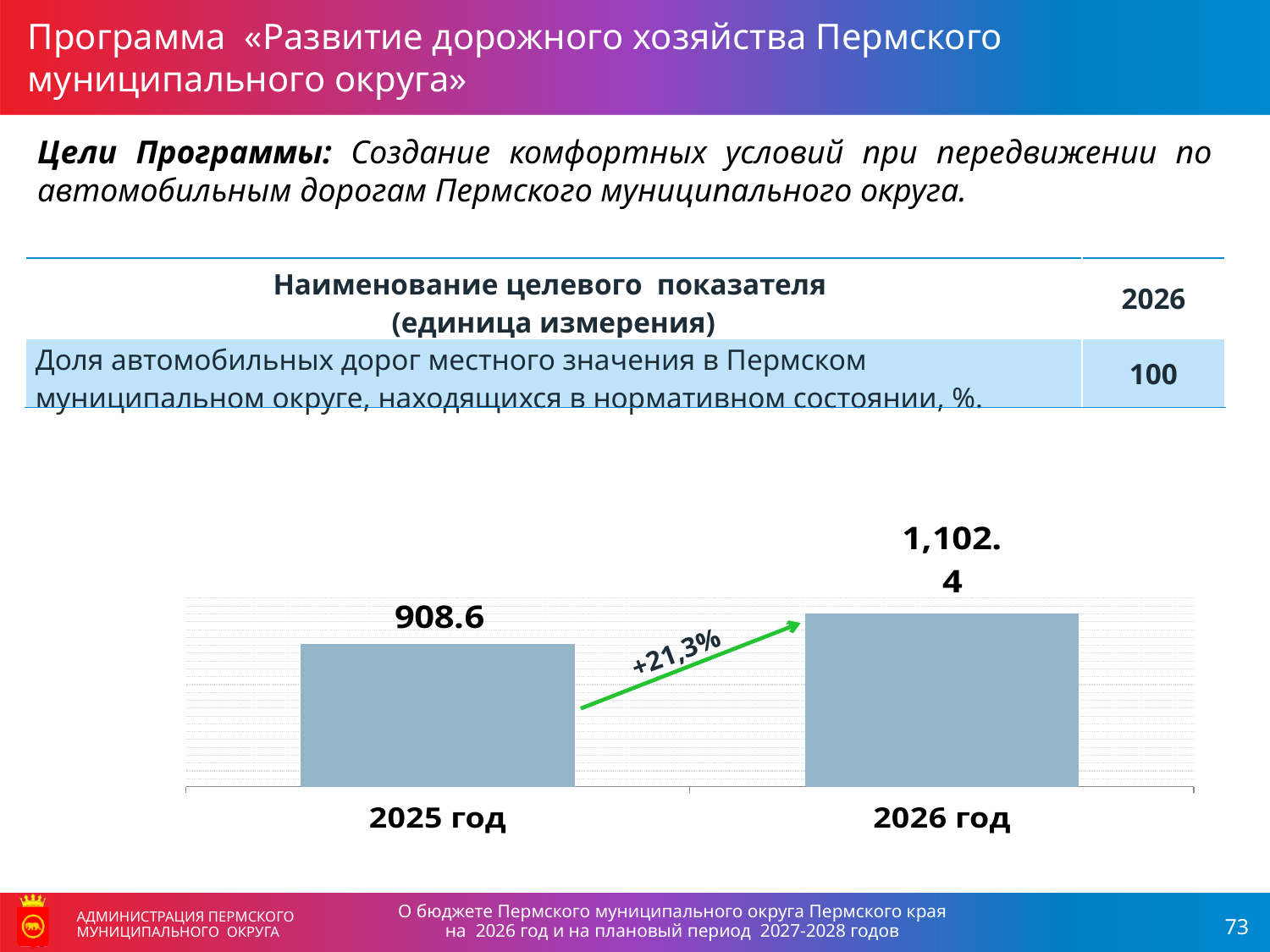
What percentage change is written on the arrow between the two bars? +21,3% Is the value for 2026 год larger or smaller than the value for 2025 год? larger How many bars are plotted in the chart? 2 Which year has the higher bar in the chart? 2026 год What type of chart is shown on the slide? bar chart What is the value shown for 2025 год in the bar chart? 908.6 Which year has the lower bar in the chart? 2025 год What is the difference between the values for 2026 год and 2025 год? 193.8 Do the values rise or fall from 2025 год to 2026 год? rise What is the value shown for 2026 год in the bar chart? 1,102.4 What are the category labels on the x axis of the chart? 2025 год, 2026 год